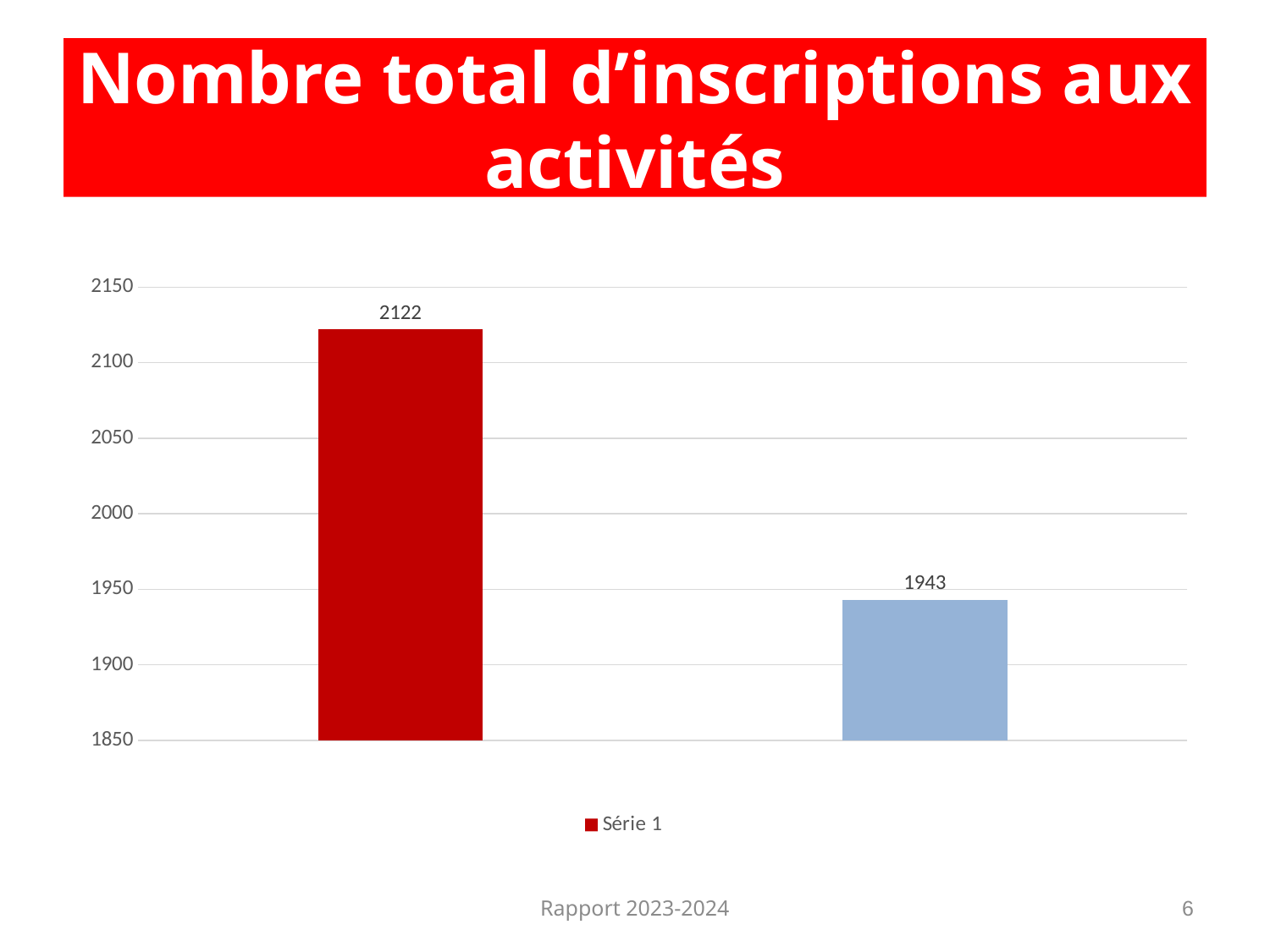
What is the value of the red bar? 2122 How many bars are plotted in the chart? 2 What is the highest value shown in the chart? 2122 What is the name of the series shown in the legend? Série 1 What kind of chart is shown on the slide? bar chart What is the lowest value shown in the chart? 1943 What is the difference between the two bar values? 179 Is the value of the red bar greater or less than 2100? greater Is the value of the blue bar greater or less than 2000? less Which bar is taller, the red one on the left or the blue one on the right? the red one on the left How many series does the legend list? 1 What is the value of the blue bar on the right? 1943